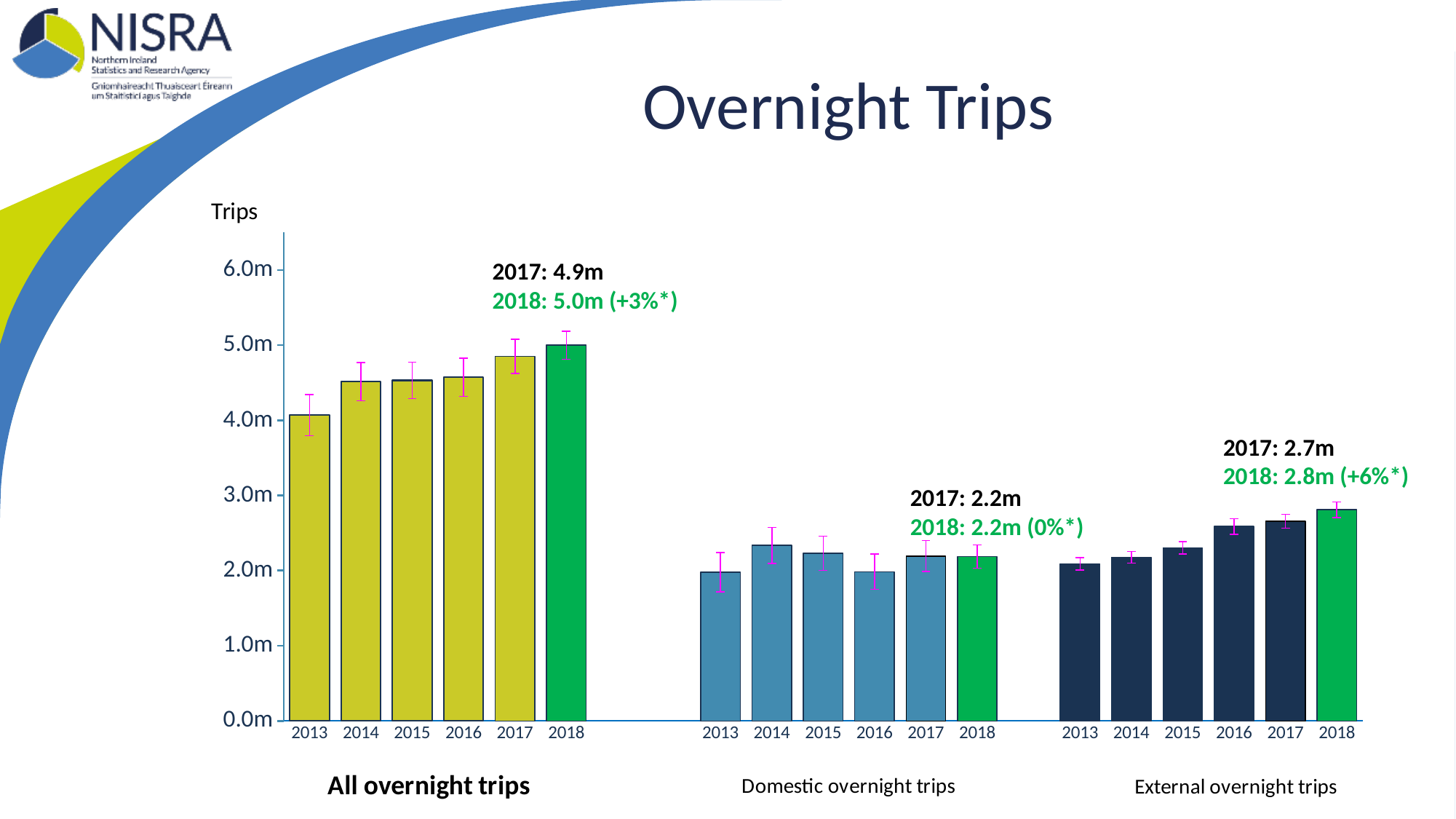
Which is larger: the 2018 value for Domestic overnight trips or the 2018 value for External overnight trips? External overnight trips (2.8m) How many years are shown for each group of overnight trips? 6 Which year has the lowest value in the All overnight trips group? 2013 Is the value for All overnight trips in 2014 greater or less than 4.0m? greater What is the value for External overnight trips in 2017? 2.7m What kind of chart is shown on the slide? Bar chart What is the value for All overnight trips in 2018? 5.0m Which year has the highest value in the All overnight trips group? 2018 What is the difference between the 2018 and 2017 values for All overnight trips? 0.1m What percentage change is shown for External overnight trips from 2017 to 2018? +6%* What is the value for Domestic overnight trips in 2018? 2.2m Is the value for External overnight trips in 2016 greater or less than 3.0m? less